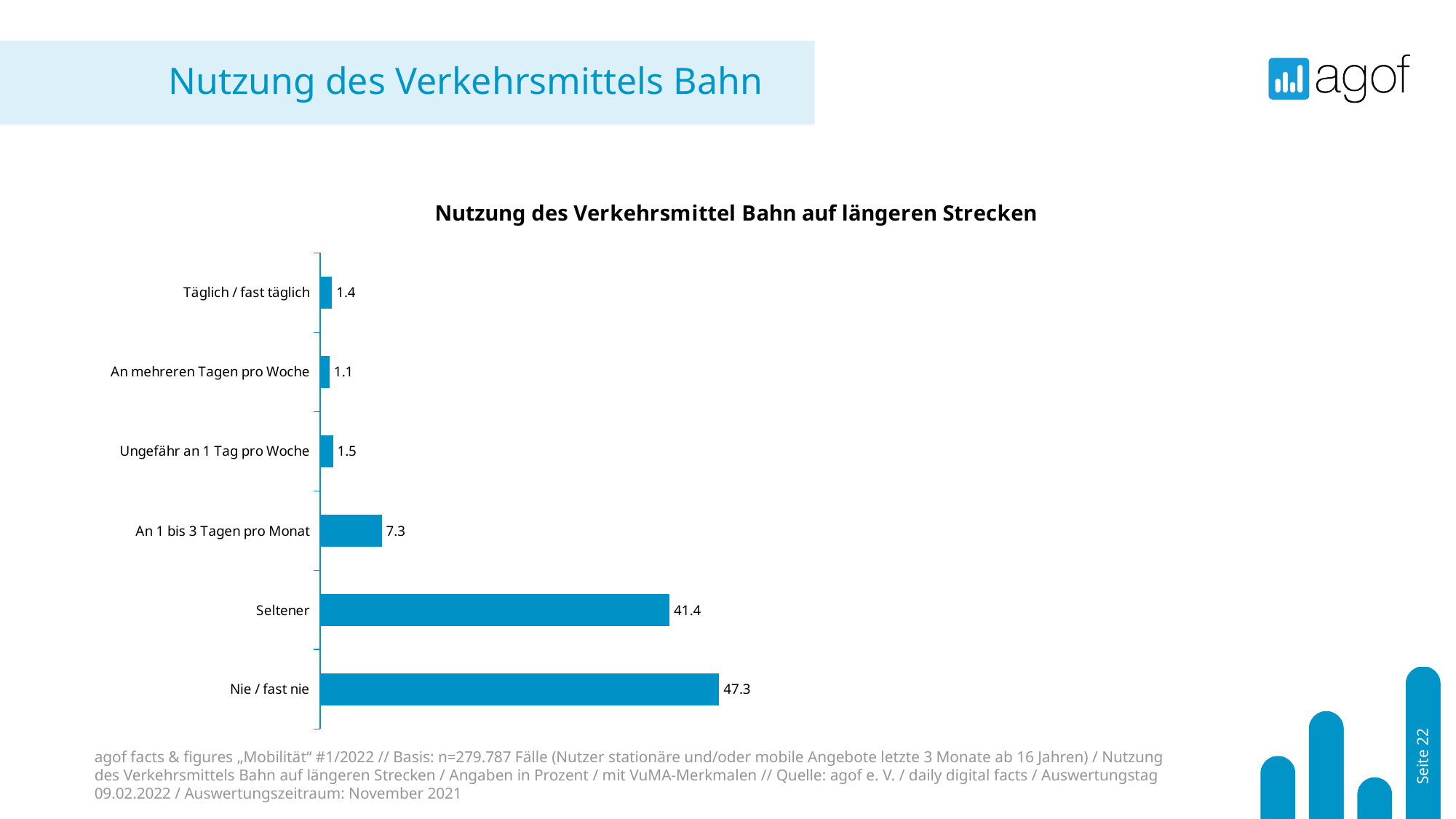
What is the value for "An 1 bis 3 Tagen pro Monat"? 7.3 Which is larger, the value for "Ungefähr an 1 Tag pro Woche" or the value for "An mehreren Tagen pro Woche"? Ungefähr an 1 Tag pro Woche What is the value for "Seltener"? 41.4 Which category has the highest value? Nie / fast nie What is the difference between the values for "An 1 bis 3 Tagen pro Monat" and "Ungefähr an 1 Tag pro Woche"? 5.8 How many categories are shown in the chart? 6 Which category has the lowest value? An mehreren Tagen pro Woche What is the value for "Nie / fast nie"? 47.3 What kind of chart is shown on the slide? Bar chart What is the difference between the values for "Nie / fast nie" and "Seltener"? 5.9 What is the title of the chart? Nutzung des Verkehrsmittel Bahn auf längeren Strecken What is the value for "Täglich / fast täglich"? 1.4